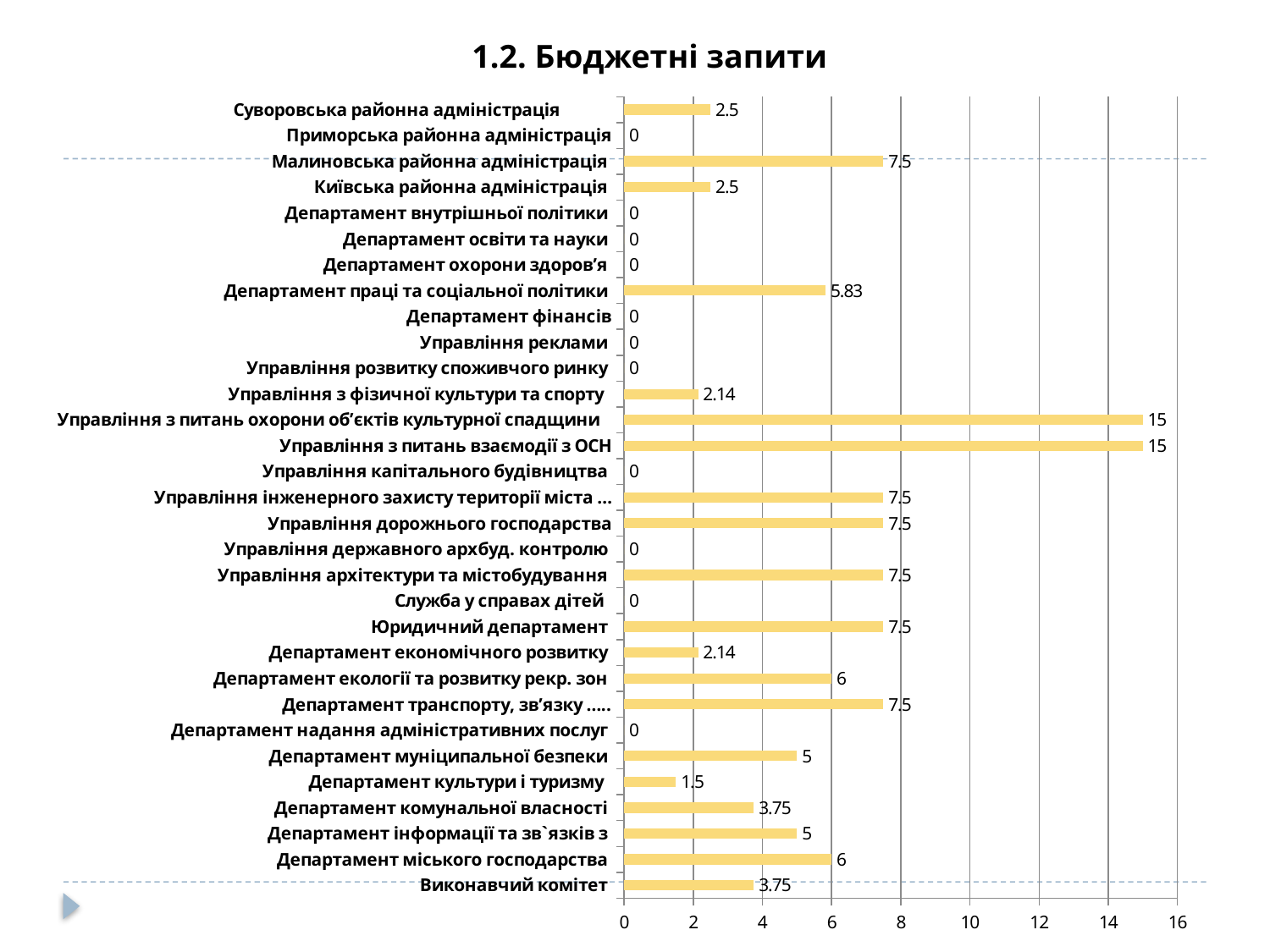
What is the difference between the values for Юридичний департамент and Департамент економічного розвитку? 5.36 How many categories are shown on the chart? 31 What is the highest value shown on the chart? 15 Which two categories share the highest value on the chart? Управління з питань охорони об'єктів культурної спадщини and Управління з питань взаємодії з ОСН What type of chart is shown on the slide? bar chart What is the value for Департамент комунальної власності? 3.75 Which is larger, the value for Департамент муніципальної безпеки or the value for Департамент екології та розвитку рекр. зон? Департамент екології та розвитку рекр. зон Is the value for Управління з питань взаємодії з ОСН greater or less than 10? greater What is the difference between the values for Департамент міського господарства and Виконавчий комітет? 2.25 What is the value for Департамент культури і туризму? 1.5 What is the value for Департамент праці та соціальної політики? 5.83 What is the value for Малиновська районна адміністрація? 7.5